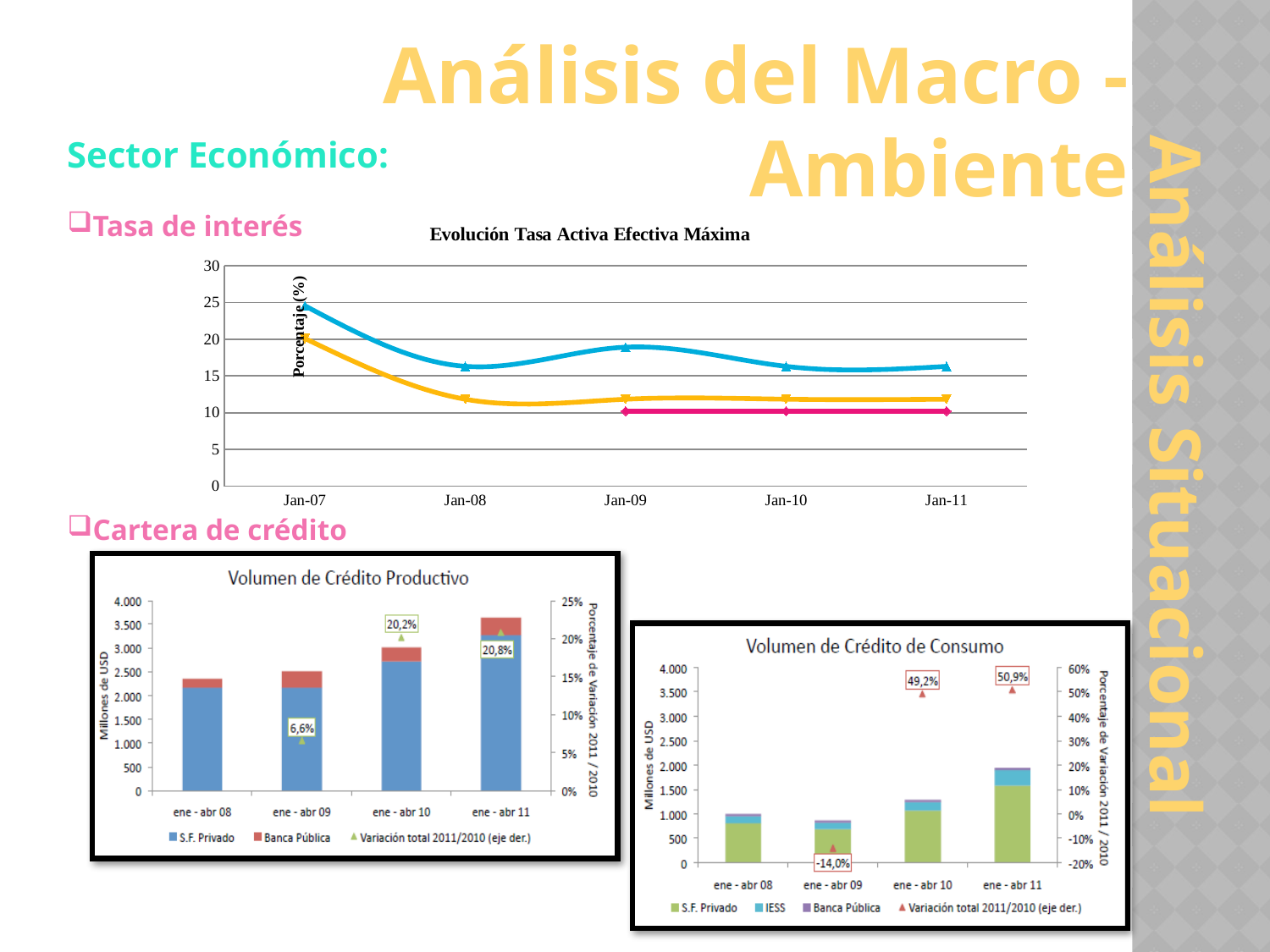
What kind of chart is 'Evolución Tasa Activa Efectiva Máxima'? line chart In the 'Evolución Tasa Activa Efectiva Máxima' chart, is the value of the orange line at Jan-08 greater or less than 15? less In the 'Volumen de Crédito de Consumo' chart, which period has the highest Variación total value? ene - abr 11 In the 'Volumen de Crédito de Consumo' chart, is the total bar height for ene - abr 10 greater or less than 1.000 Millones de USD? greater In the 'Volumen de Crédito Productivo' chart, what is the Variación total value labelled for ene - abr 09? 6,6% In the 'Evolución Tasa Activa Efectiva Máxima' chart, does the blue line rise or fall from Jan-07 to Jan-08? fall In the 'Evolución Tasa Activa Efectiva Máxima' chart, is the value of the blue line at Jan-07 greater or less than 20? greater In the 'Volumen de Crédito Productivo' chart, what is the difference between the Variación total values for ene - abr 11 and ene - abr 10? 0,6% How many entries does the legend of the 'Volumen de Crédito de Consumo' chart list? 4 In the 'Volumen de Crédito de Consumo' chart, what is the Variación total value labelled for ene - abr 09? -14,0% In the 'Evolución Tasa Activa Efectiva Máxima' chart, how many dates are shown on the x axis? 5 How many entries does the legend of the 'Volumen de Crédito Productivo' chart list? 3